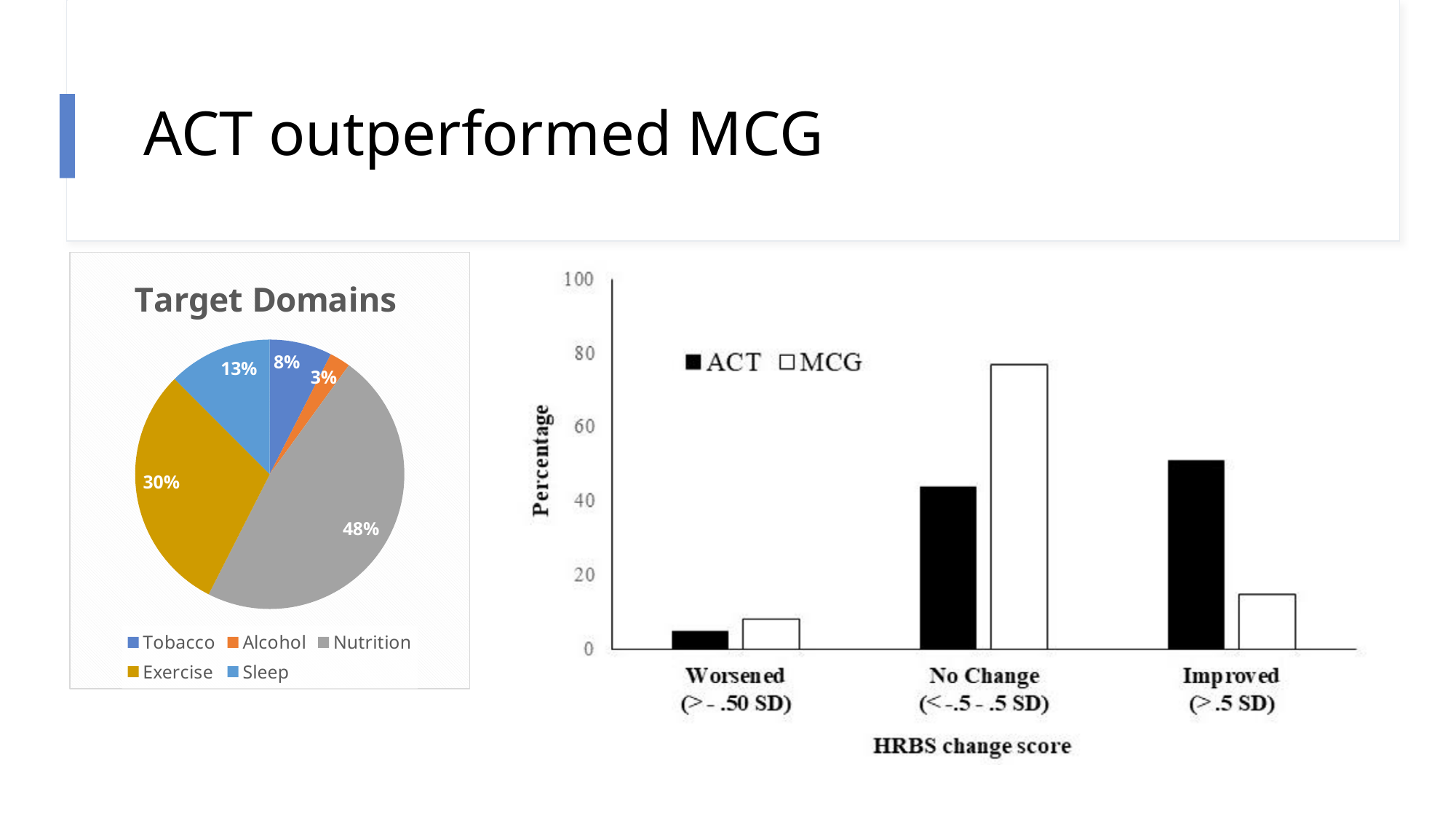
In the HRBS change score chart on the right, is the MCG value for No Change greater or less than 60? greater In the HRBS change score chart on the right, which series has the larger value for Improved, ACT or MCG? ACT In the HRBS change score chart on the right, how many series does the legend list? 2 In the Target Domains pie chart, what percentage is Exercise? 30% In the Target Domains pie chart, which domain has the largest share? Nutrition What kind of chart is the Target Domains chart? Pie chart In the Target Domains pie chart, what is the difference between the Exercise and Sleep shares? 17% In the Target Domains pie chart, what percentage is Nutrition? 48% How many slices does the Target Domains pie chart have? 5 In the HRBS change score chart on the right, is the MCG value for Improved greater or less than 20? less What kind of chart is the HRBS change score chart on the right? Bar chart In the Target Domains pie chart, which domain has the smallest share? Alcohol